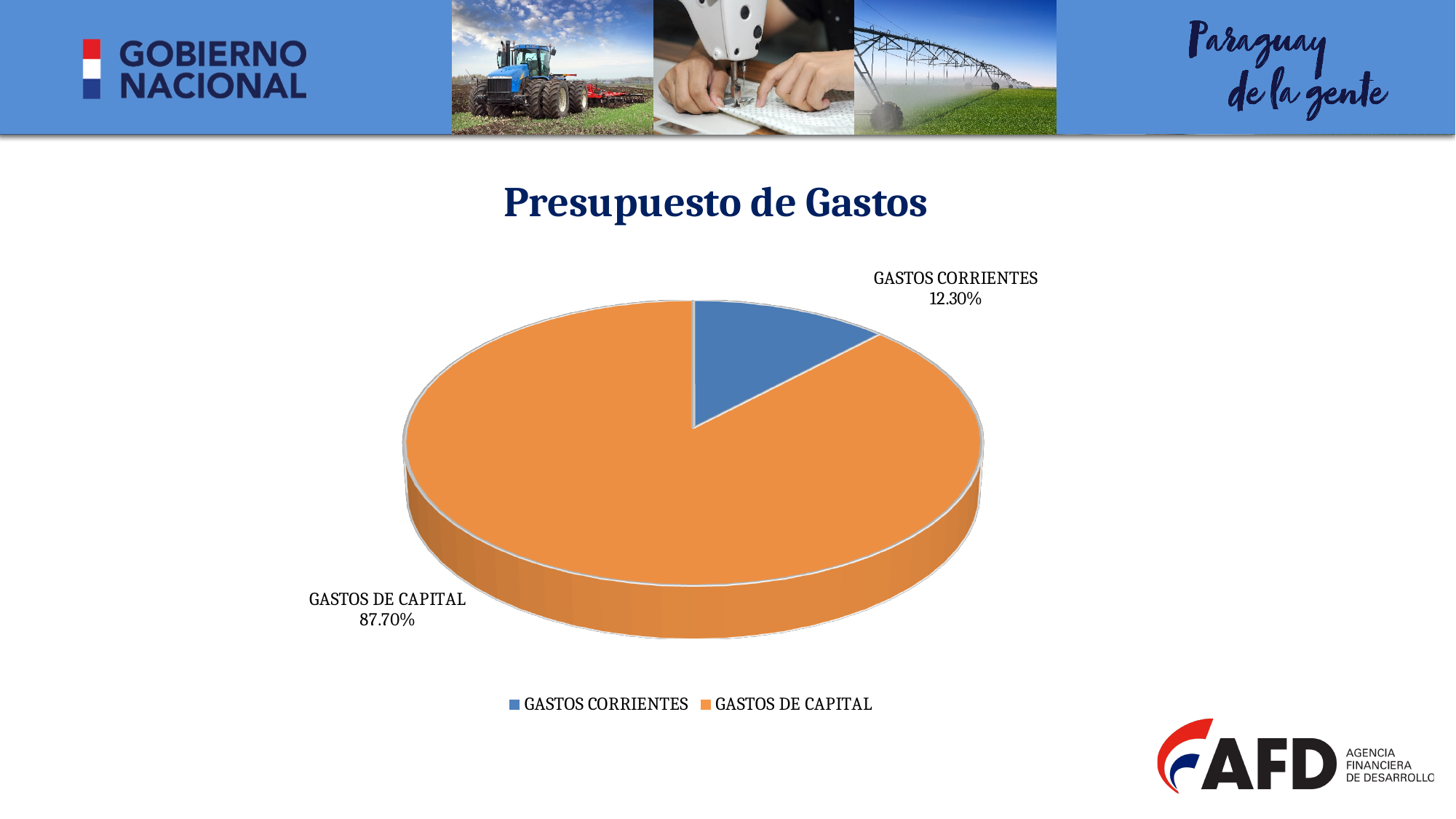
What is the difference in percentage points between GASTOS DE CAPITAL and GASTOS CORRIENTES? 75.40% What kind of chart is shown on the slide? Pie chart What share of the pie does GASTOS CORRIENTES represent? 12.30% What colour is the GASTOS CORRIENTES slice? Blue Which is larger, GASTOS CORRIENTES or GASTOS DE CAPITAL? GASTOS DE CAPITAL How many categories are shown in the pie chart? 2 What is the title of the chart? Presupuesto de Gastos Which category has the largest slice of the pie? GASTOS DE CAPITAL How many entries does the legend list? 2 Which category has the smallest slice of the pie? GASTOS CORRIENTES What share of the pie does GASTOS DE CAPITAL represent? 87.70%